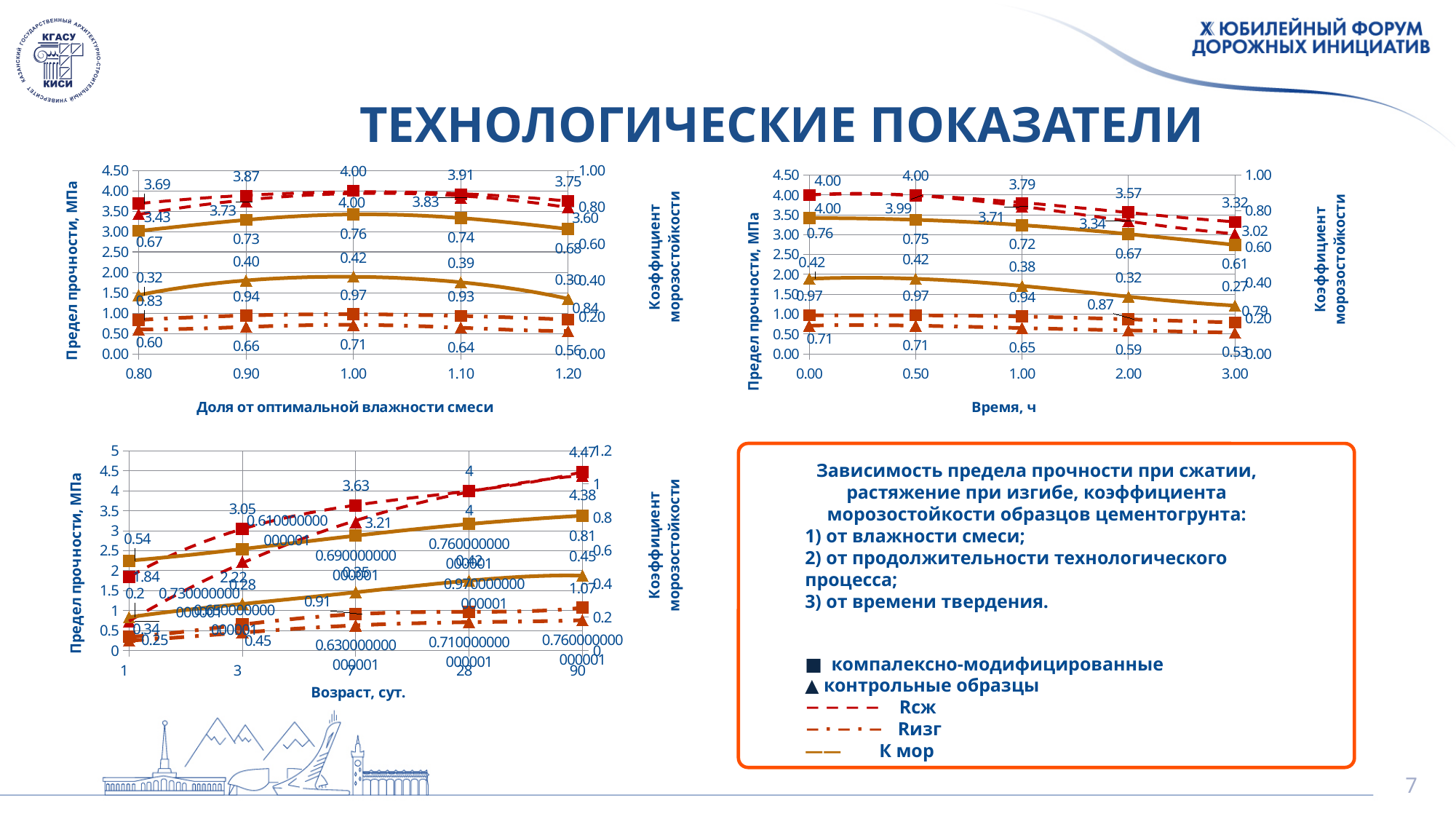
What kind of chart is the bottom-left chart (x axis 'Возраст, сут.')? line chart In the top-left chart (x axis 'Доля от оптимальной влажности смеси'), what is the Rсж value for the complex-modified samples at 1.00? 4.00 In the top-left chart (x axis 'Доля от оптимальной влажности смеси'), what is the Rизг value for the control samples at 1.20? 0.56 In the top-left chart (x axis 'Доля от оптимальной влажности смеси'), at which x value is K мор for the complex-modified samples highest? 1.00 In the top-right chart (x axis 'Время, ч'), what is the Rсж value for the complex-modified samples at 3.00? 3.32 In the top-right chart (x axis 'Время, ч'), what is the Rизг value for the complex-modified samples at 1.00? 0.94 In the top-left chart (x axis 'Доля от оптимальной влажности смеси'), what is the K мор value for the complex-modified samples at 0.80? 0.67 How many x-axis points are plotted in the top-left chart (x axis 'Доля от оптимальной влажности смеси')? 5 In the top-right chart (x axis 'Время, ч'), at which x value is Rизг for the control samples lowest? 3.00 In the top-right chart (x axis 'Время, ч'), what is the K мор value for the control samples at 2.00? 0.32 In the top-right chart (x axis 'Время, ч'), does Rсж for the complex-modified samples rise or fall from 0.00 to 3.00? fall In the top-right chart (x axis 'Время, ч'), what is the difference between the Rсж values of the complex-modified and control samples at 3.00? 0.30